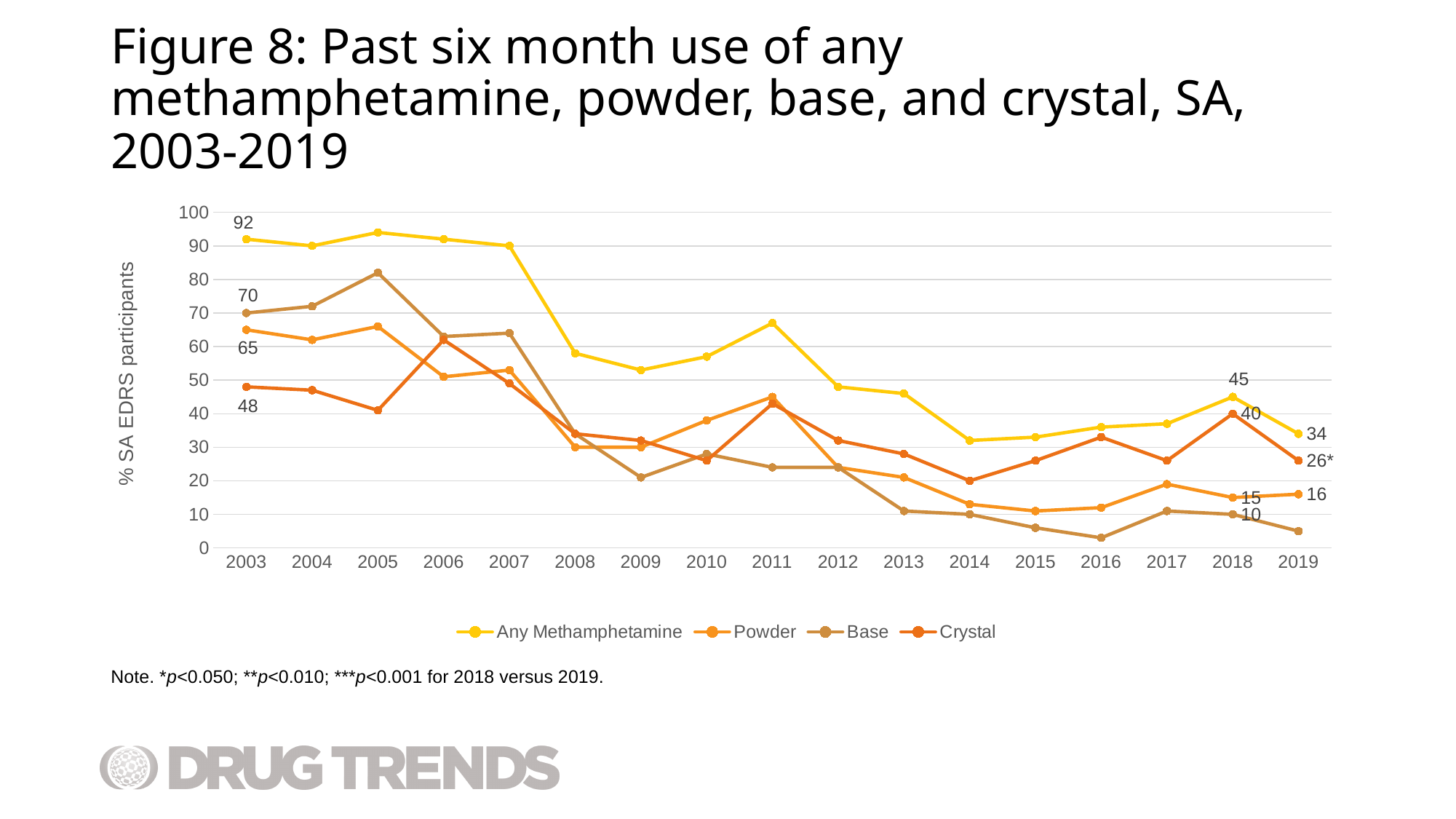
What is the value for Crystal in 2019? 26* What is the value for Any Methamphetamine in 2003? 92 By how much did the Crystal value change from 2018 to 2019? 14 In 2003, which is larger: the value for Powder or the value for Crystal? Powder How many series does the legend list? 4 How many years are shown on the x axis? 17 What kind of chart is shown on the slide? line chart Is the value for Base in 2019 greater or less than 10? less What is the value for Powder in 2018? 15 What is the difference between the Any Methamphetamine values in 2003 and 2019? 58 What is the value for Base in 2003? 70 Does the Any Methamphetamine series rise or fall overall from 2003 to 2019? fall